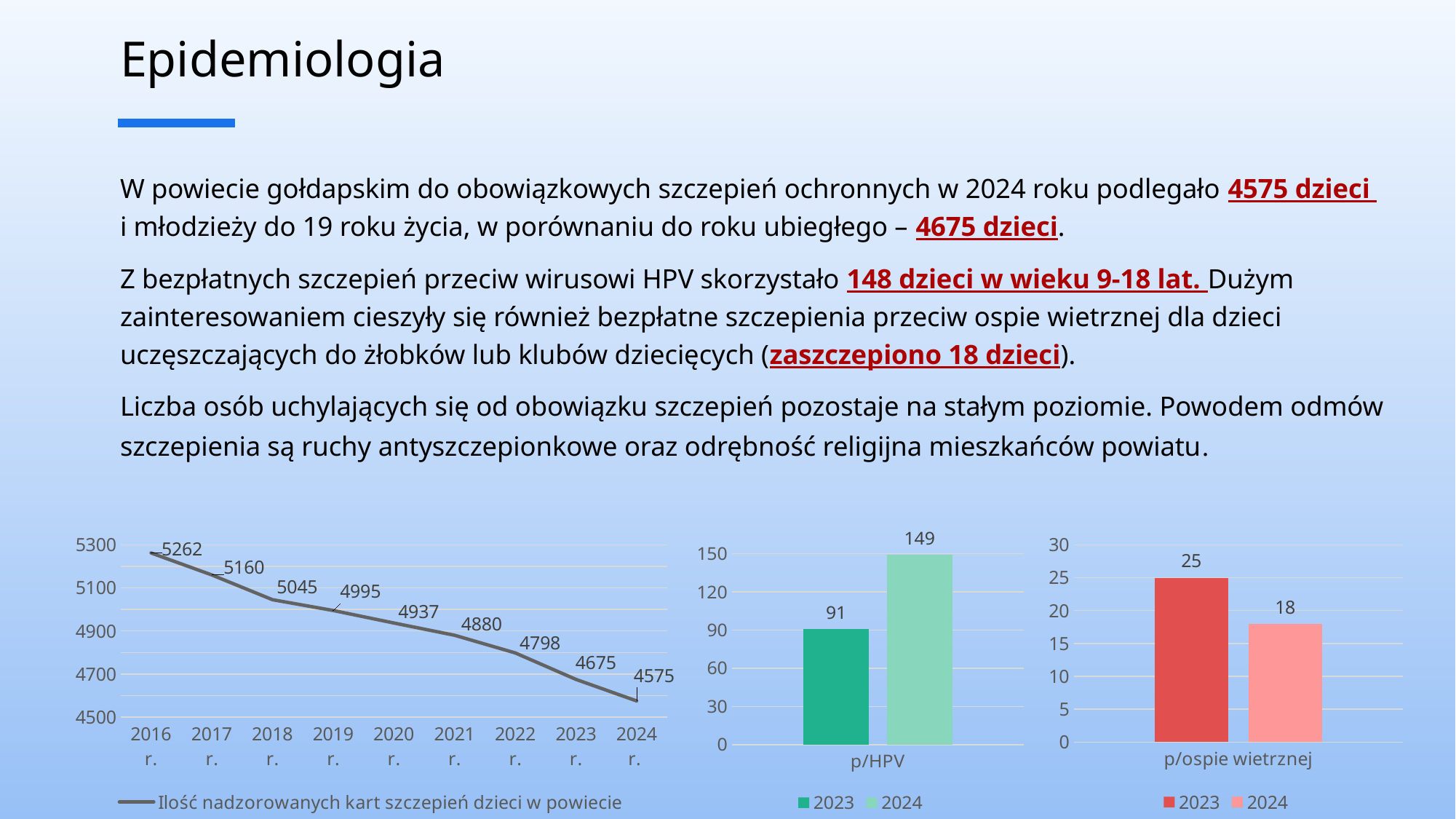
In the right chart (p/ospie wietrznej), what is the value for 2024? 18 How many years are plotted in the left line chart? 9 In the left line chart, do the values rise or fall from 2016 r. to 2024 r.? fall In the middle chart (p/HPV), what is the value for 2024? 149 In the left line chart, which year has the lowest value? 2024 r. In the right chart (p/ospie wietrznej), which year has the higher value, 2023 or 2024? 2023 In the left line chart, what is the difference between the values for 2016 r. and 2024 r.? 687 In the left line chart, what is the value for 2016 r.? 5262 In the left line chart, what is the value for 2024 r.? 4575 How many series does the legend of the middle chart (p/HPV) list? 2 In the middle chart (p/HPV), what is the difference between the 2024 and 2023 values? 58 What type of chart is the chart on the left of the slide? line chart